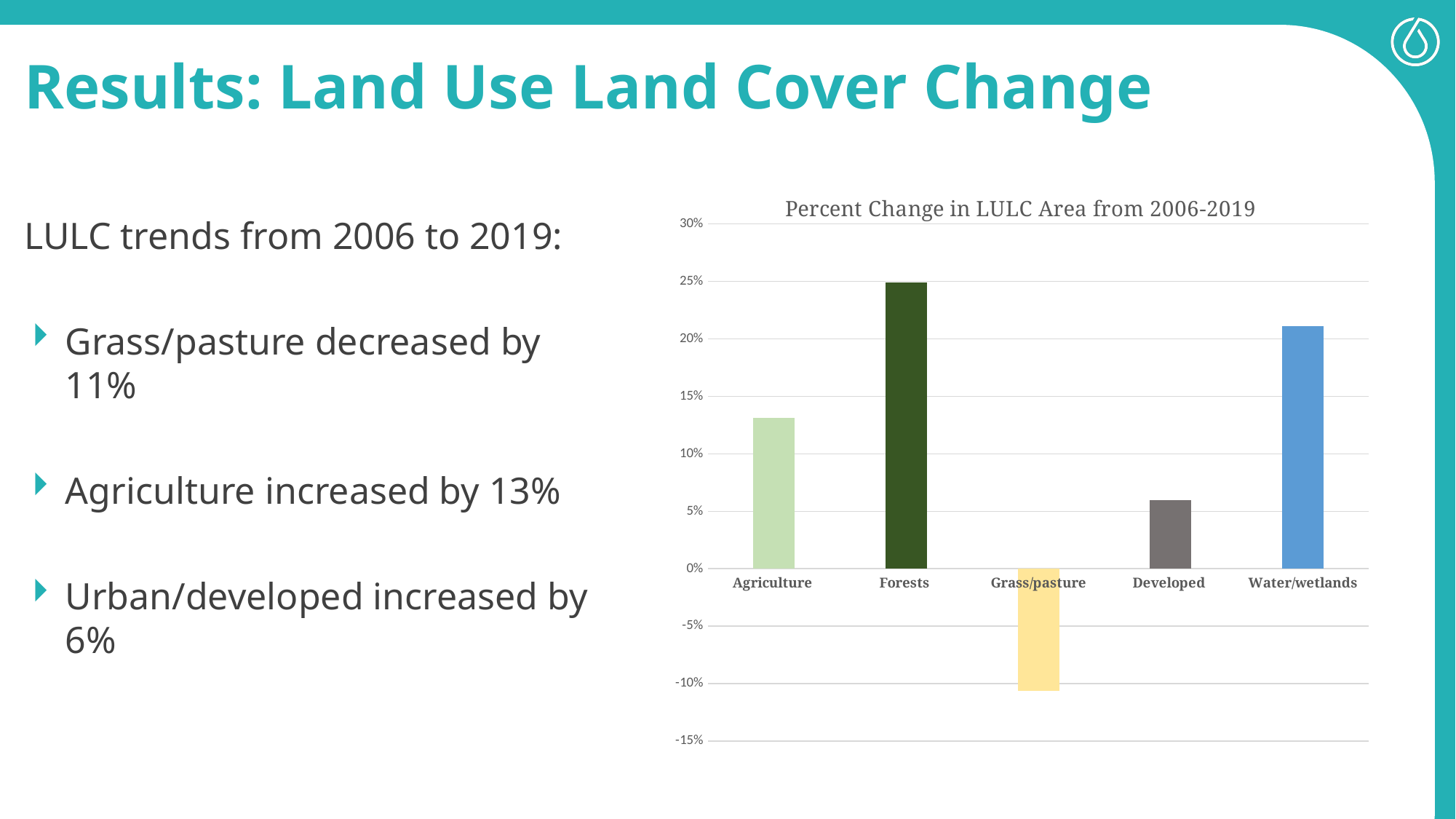
Is the percent change for Water/wetlands greater or less than 15%? greater Which category has the lowest percent change in the chart? Grass/pasture Is the percent change for Grass/pasture greater or less than -5%? less What type of chart is shown on the slide? bar chart How many land cover categories are shown on the x axis of the chart? 5 Which has a larger percent change, Water/wetlands or Agriculture? Water/wetlands Is the percent change for Developed greater or less than 10%? less Which has a larger percent change, Forests or Developed? Forests Which category is the only one with a negative percent change in the chart? Grass/pasture What is the title of the chart? Percent Change in LULC Area from 2006-2019 Which category has the highest percent change in the chart? Forests